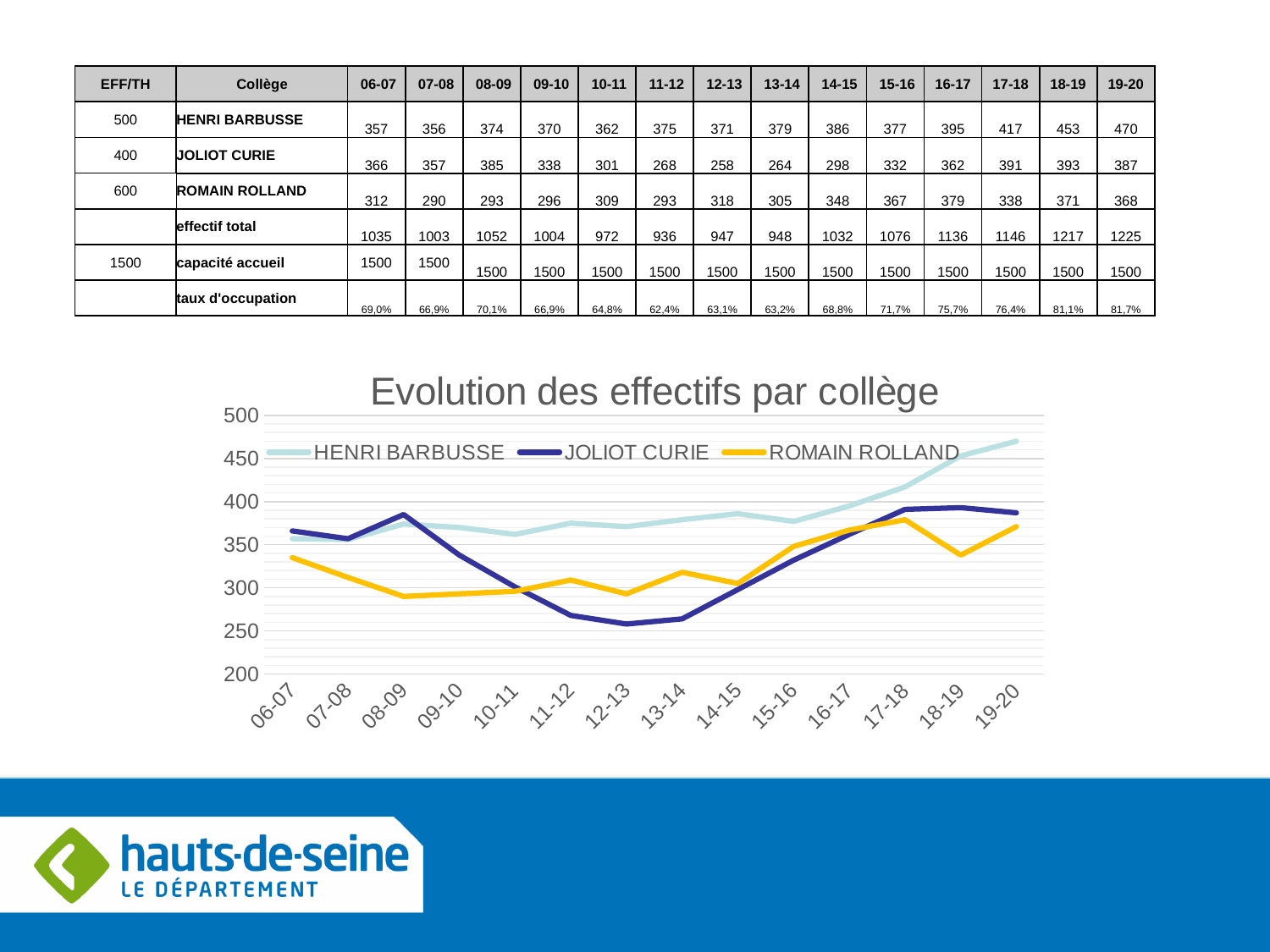
What is the value for JOLIOT CURIE in 12-13? 258 How many series does the legend of the chart list? 3 What kind of chart is shown on the slide? line chart What is the value for HENRI BARBUSSE in 19-20? 470 Which is larger in 11-12, the value for HENRI BARBUSSE or the value for JOLIOT CURIE? HENRI BARBUSSE How many school years are plotted along the x axis of the chart? 14 What is the difference between the HENRI BARBUSSE value in 19-20 and its value in 06-07? 113 What is the title of the chart? Evolution des effectifs par collège Which collège has the highest value in 19-20? HENRI BARBUSSE Is the value for JOLIOT CURIE in 12-13 greater or less than 300? less Does the HENRI BARBUSSE line rise or fall from 15-16 to 19-20? rise In which school year does JOLIOT CURIE reach its lowest value? 12-13